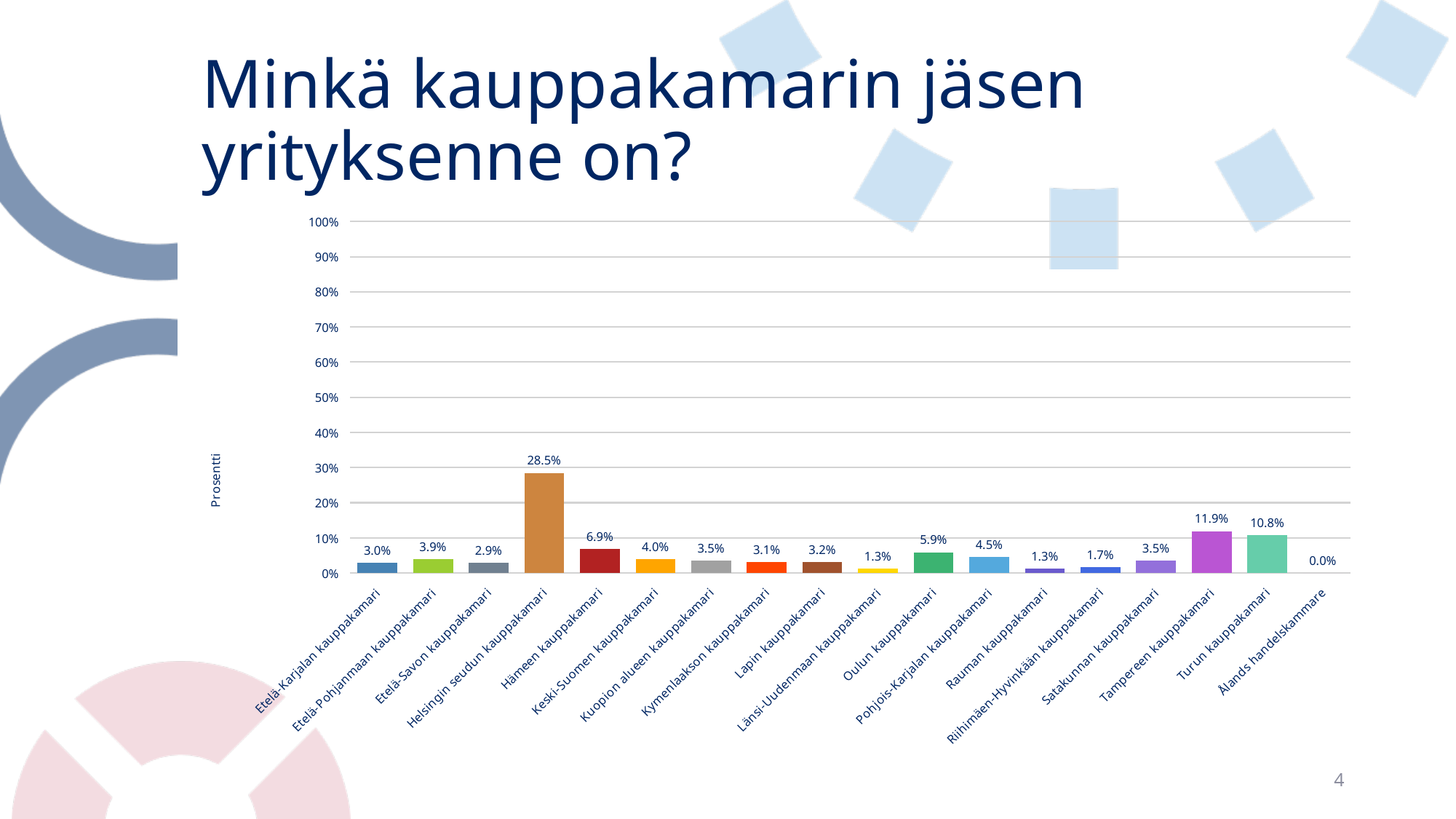
Which category has the lowest value? Ålands handelskammare What is the value for Oulun kauppakamari? 5.9% What is the value for Tampereen kauppakamari? 11.9% What is the value for Riihimäen-Hyvinkään kauppakamari? 1.7% What is the label of the y axis? Prosentti What is the difference between the values for Helsingin seudun kauppakamari and Hämeen kauppakamari? 21.6% Which category has the highest value? Helsingin seudun kauppakamari Which is larger, the value for Oulun kauppakamari or the value for Pohjois-Karjalan kauppakamari? Oulun kauppakamari What is the value for Helsingin seudun kauppakamari? 28.5% What kind of chart is shown on the slide? Bar chart What is the difference between the values for Tampereen kauppakamari and Turun kauppakamari? 1.1% How many categories are shown on the x axis? 18